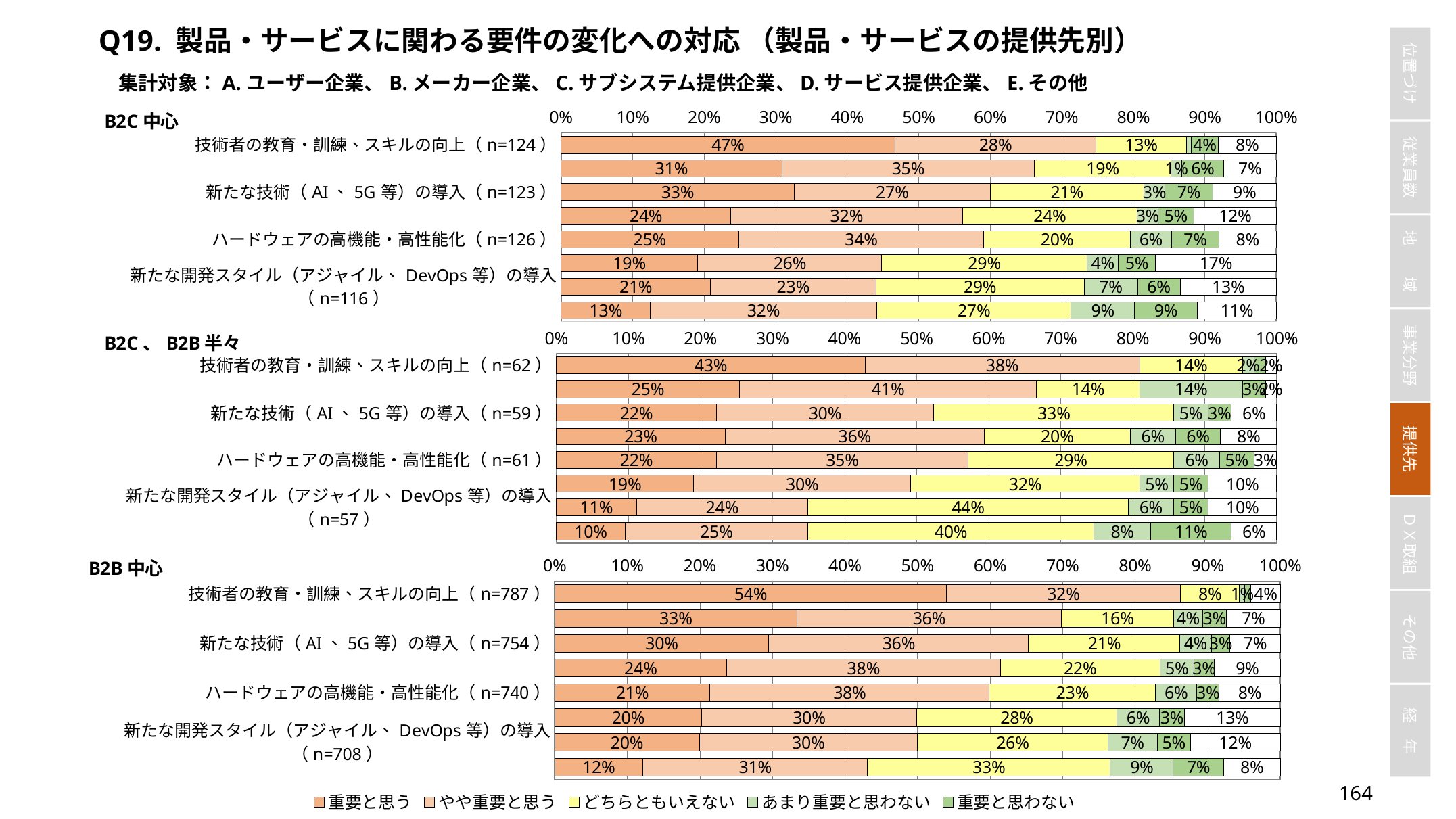
Which is larger for 技術者の教育・訓練、スキルの向上: the 重要と思う value in the B2C 中心 chart or in the B2B 中心 chart? B2B 中心 In the B2C 中心 chart, what is the 重要と思う value for ハードウェアの高機能・高性能化（n=126）? 25% What is the difference between the 重要と思う value for 技術者の教育・訓練、スキルの向上 in the B2B 中心 chart and in the B2C 中心 chart? 7 percentage points In the B2B 中心 chart, what is the やや重要と思う value for ハードウェアの高機能・高性能化（n=740）? 38% What kind of chart is used on this slide? Stacked bar chart In the B2B 中心 chart, what is the 重要と思う value for 技術者の教育・訓練、スキルの向上（n=787）? 54% In the B2C、B2B 半々 chart, what is the やや重要と思う value for 技術者の教育・訓練、スキルの向上（n=62）? 38% In the B2C 中心 chart, what is the 重要と思う value for 技術者の教育・訓練、スキルの向上（n=124）? 47% In the B2C 中心 chart, what is the どちらともいえない value for 新たな技術（AI、5G 等）の導入（n=123）? 21% What is the first entry in the legend at the bottom of the slide? 重要と思う In the B2C、B2B 半々 chart, what is the どちらともいえない value for ハードウェアの高機能・高性能化（n=61）? 29% How many series does the legend at the bottom of the slide list? 5